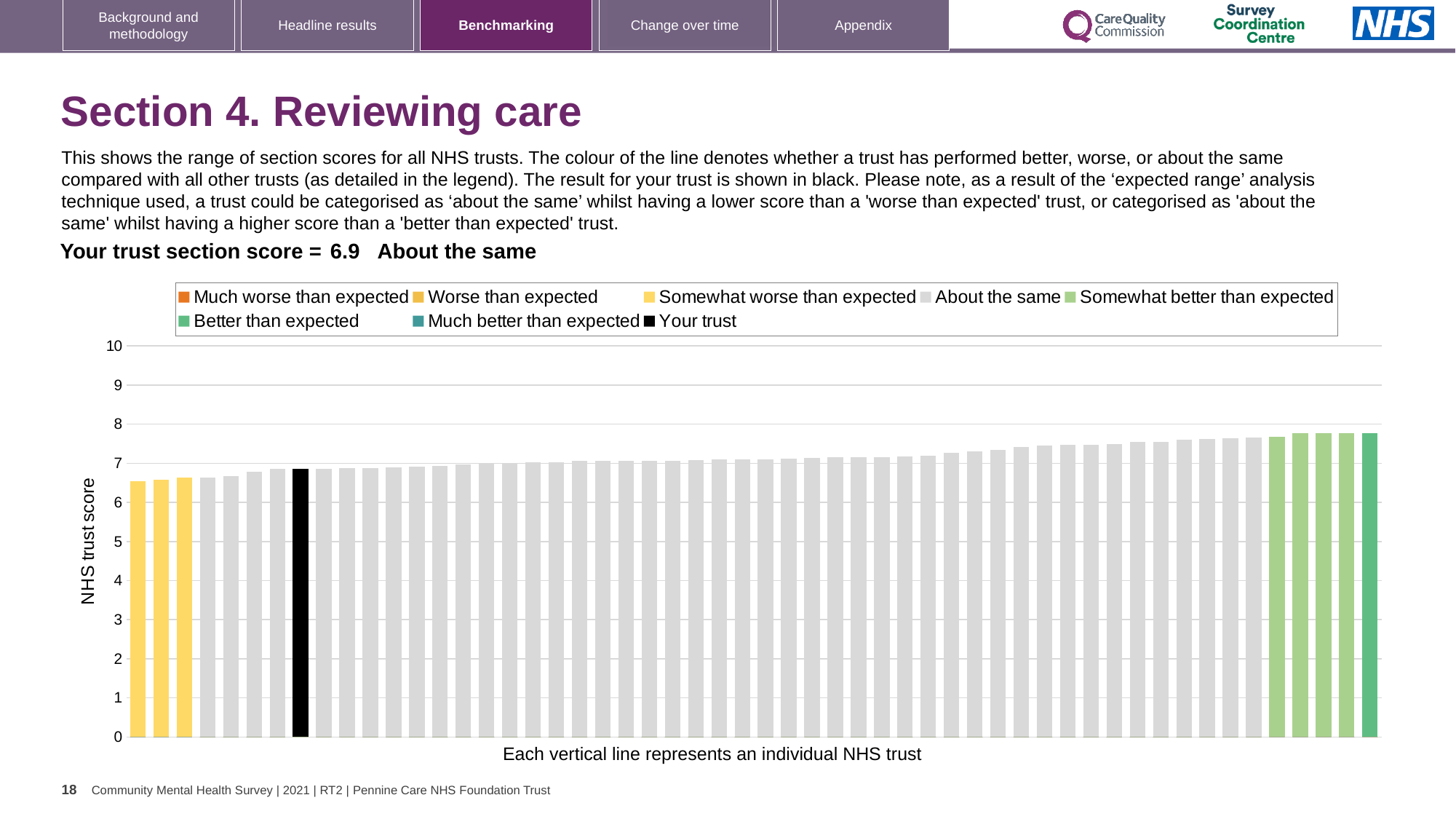
How many bars are coloured yellow (Somewhat worse than expected)? 3 What kind of chart is shown on the slide? bar chart Is the value of the highest bar greater or less than 8? less Which is larger: the value for your trust (black bar) or the value of the first yellow bar on the left? Your trust Do the bar values rise or fall from left to right along the x axis? rise What is the section score for your trust? 6.9 What is the highest value shown on the y axis? 10 Is the value of the lowest bar greater or less than 6? greater How many entries does the chart legend list? 8 Which category is your trust placed in for this section? About the same Is the value for your trust greater or less than 5? greater What is the label on the y axis of the chart? NHS trust score